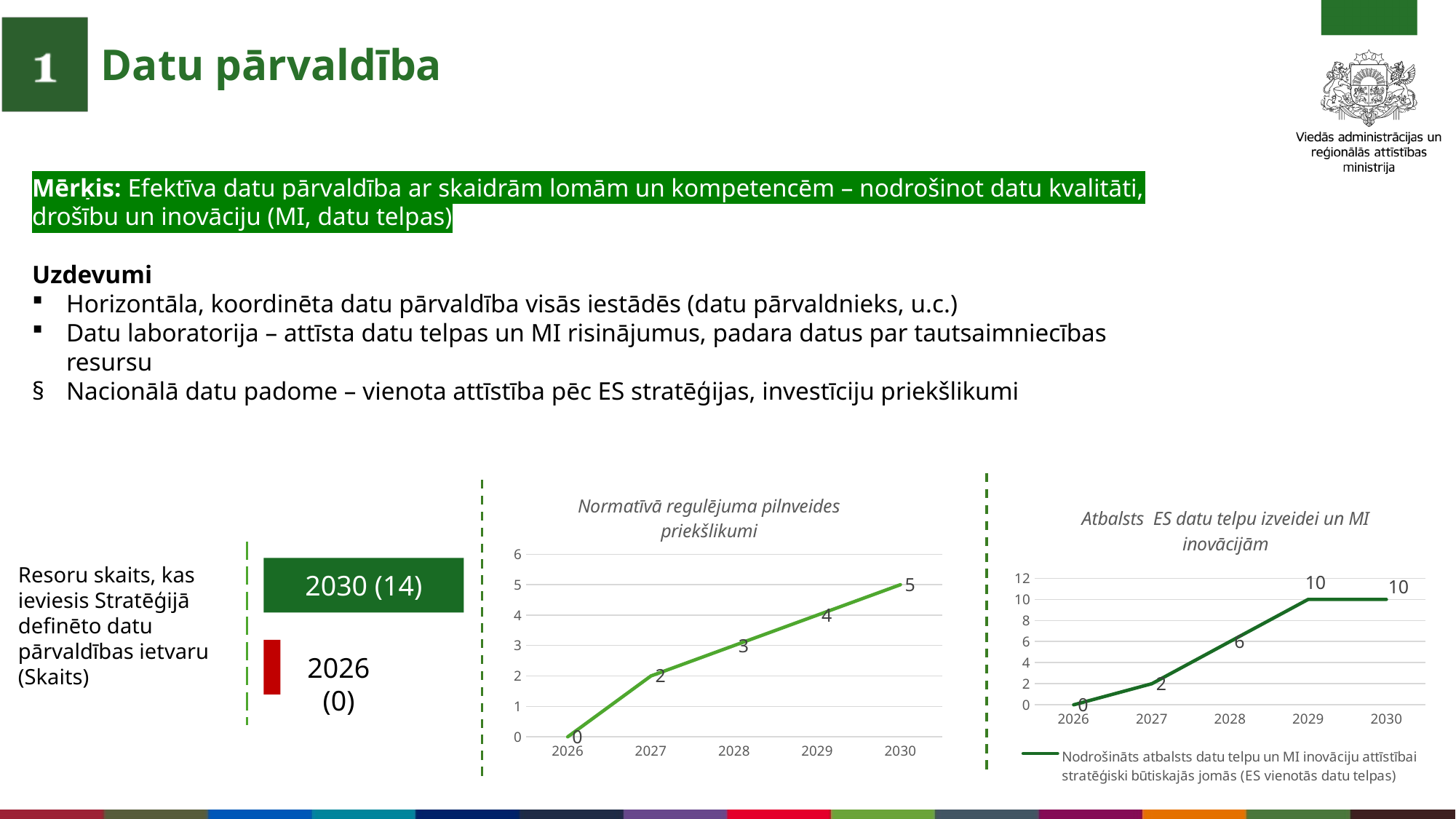
In the chart titled "Atbalsts ES datu telpu izveidei un MI inovācijām", which is larger, the value for 2028 or the value for 2027? 2028 How many series does the legend of the chart titled "Atbalsts ES datu telpu izveidei un MI inovācijām" list? 1 In the chart titled "Atbalsts ES datu telpu izveidei un MI inovācijām", what is the value for 2028? 6 How many years are plotted on the x axis of the chart titled "Normatīvā regulējuma pilnveides priekšlikumi"? 5 In the chart titled "Normatīvā regulējuma pilnveides priekšlikumi", what is the value for 2030? 5 In the chart titled "Normatīvā regulējuma pilnveides priekšlikumi", what is the value for 2028? 3 In the chart titled "Normatīvā regulējuma pilnveides priekšlikumi", do the values rise or fall from 2026 to 2030? rise What kind of chart is the chart titled "Atbalsts ES datu telpu izveidei un MI inovācijām"? line chart In the chart titled "Atbalsts ES datu telpu izveidei un MI inovācijām", what is the value for 2029? 10 In the chart titled "Normatīvā regulējuma pilnveides priekšlikumi", which year has the lowest value? 2026 In the chart titled "Atbalsts ES datu telpu izveidei un MI inovācijām", what is the difference between the values for 2029 and 2027? 8 In the chart titled "Normatīvā regulējuma pilnveides priekšlikumi", what is the difference between the values for 2030 and 2027? 3